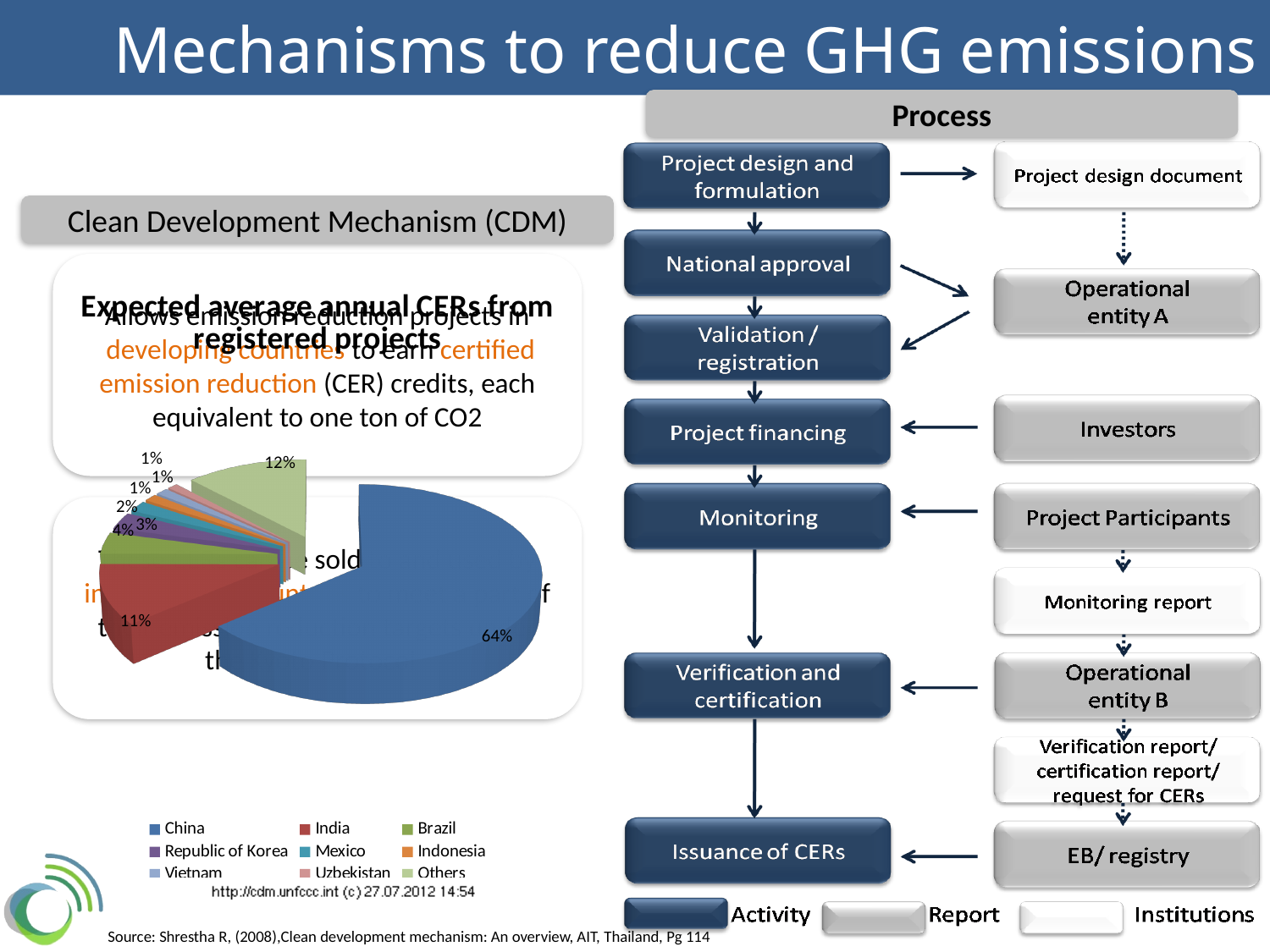
Which legend entry is listed first in the pie chart's legend? China What kind of chart is shown on the slide? pie chart How many entries does the pie chart's legend list? 9 What is the title of the pie chart? Expected average annual CERs from registered projects What share of the pie does China account for? 64% By how many percentage points does China's share exceed India's share? 53 Which is larger in the pie chart, the share for India or the share for Others? Others What is the value shown for Others in the pie chart? 12% Is the share for China greater or less than 50%? greater Which country has the largest slice of the pie chart? China What is the value shown for India in the pie chart? 11%